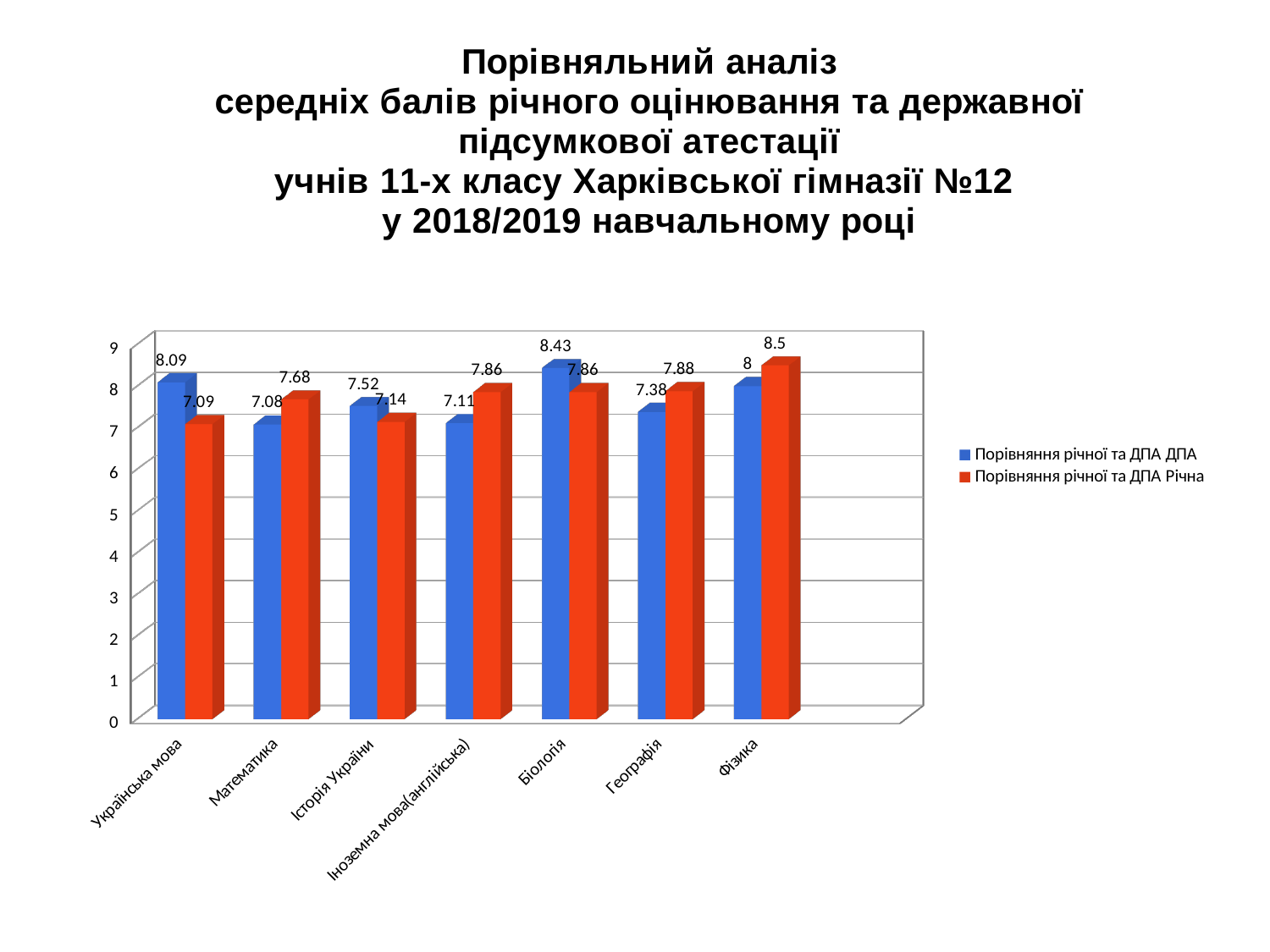
What kind of chart is shown on the slide? Bar chart What is the Річна value for Фізика? 8.5 What is the Річна value for Українська мова? 7.09 Which is larger for Географія, the ДПА value or the Річна value? Річна What is the ДПА value for Біологія? 8.43 What is the difference between the ДПА and Річна values for Українська мова? 1 What colour are the bars for the series 'Порівняння річної та ДПА Річна'? Red How many subjects are shown on the x axis? 7 How many series does the legend list? 2 Which subject has the highest ДПА value? Біологія Which subject has the lowest Річна value? Українська мова What is the ДПА value for Математика? 7.08